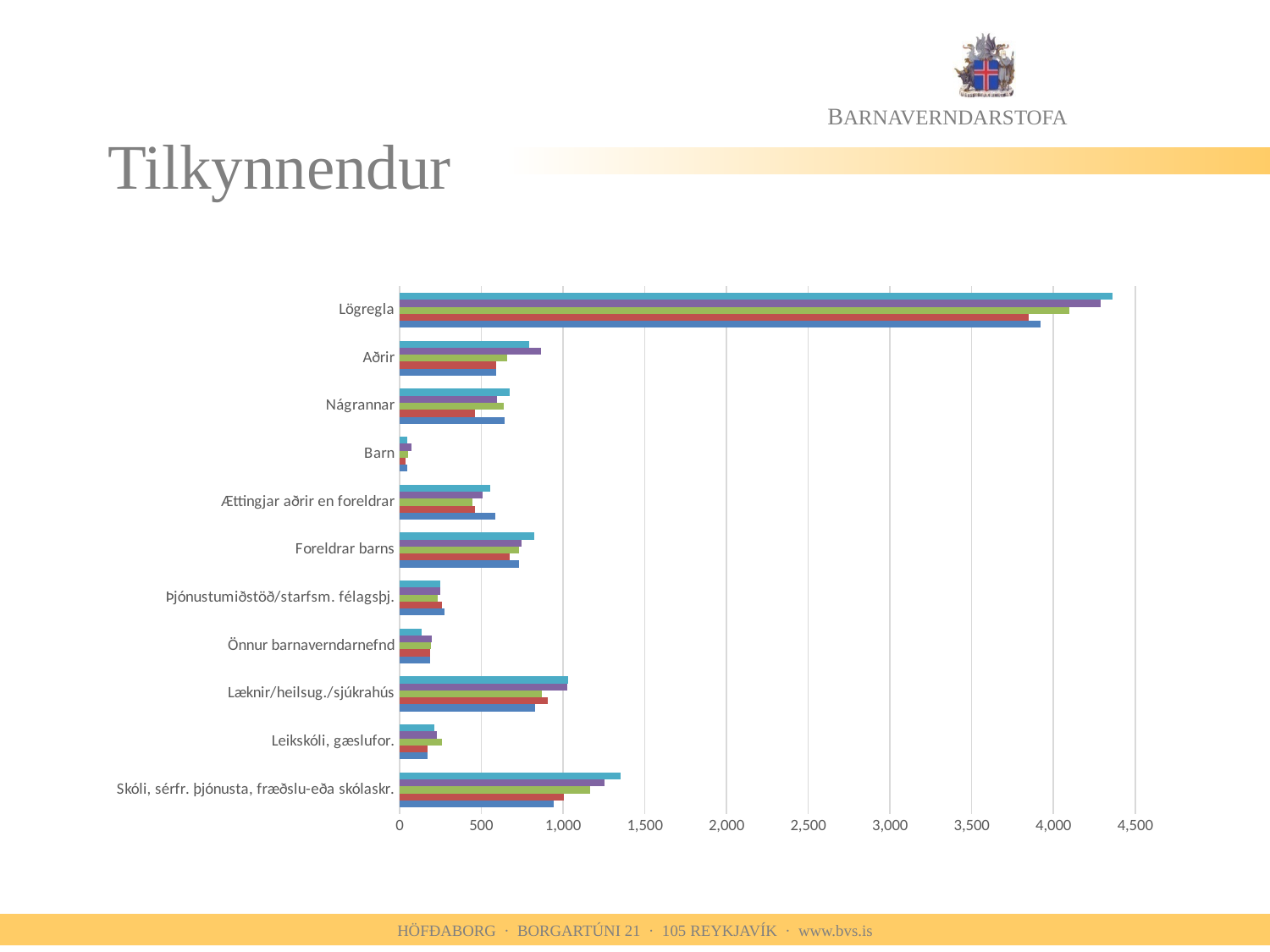
What is the title of the slide containing the chart? Tilkynnendur What kind of chart is shown on the slide? bar chart Which category has the lowest values in the chart? Barn Are the values for Barn greater or less than 500? less What is the highest tick value shown on the horizontal axis? 4,500 How many bars are plotted for each category in the chart? 5 Are the values for Foreldrar barns greater or less than 1,000? less Which category has the highest values in the chart? Lögregla How many categories are listed on the vertical axis of the chart? 11 Are the values for Lögregla greater or less than 3,500? greater Which category has larger values, Nágrannar or Barn? Nágrannar Which category has larger values, Skóli, sérfr. þjónusta, fræðslu-eða skólaskr. or Leikskóli, gæslufor.? Skóli, sérfr. þjónusta, fræðslu-eða skólaskr.